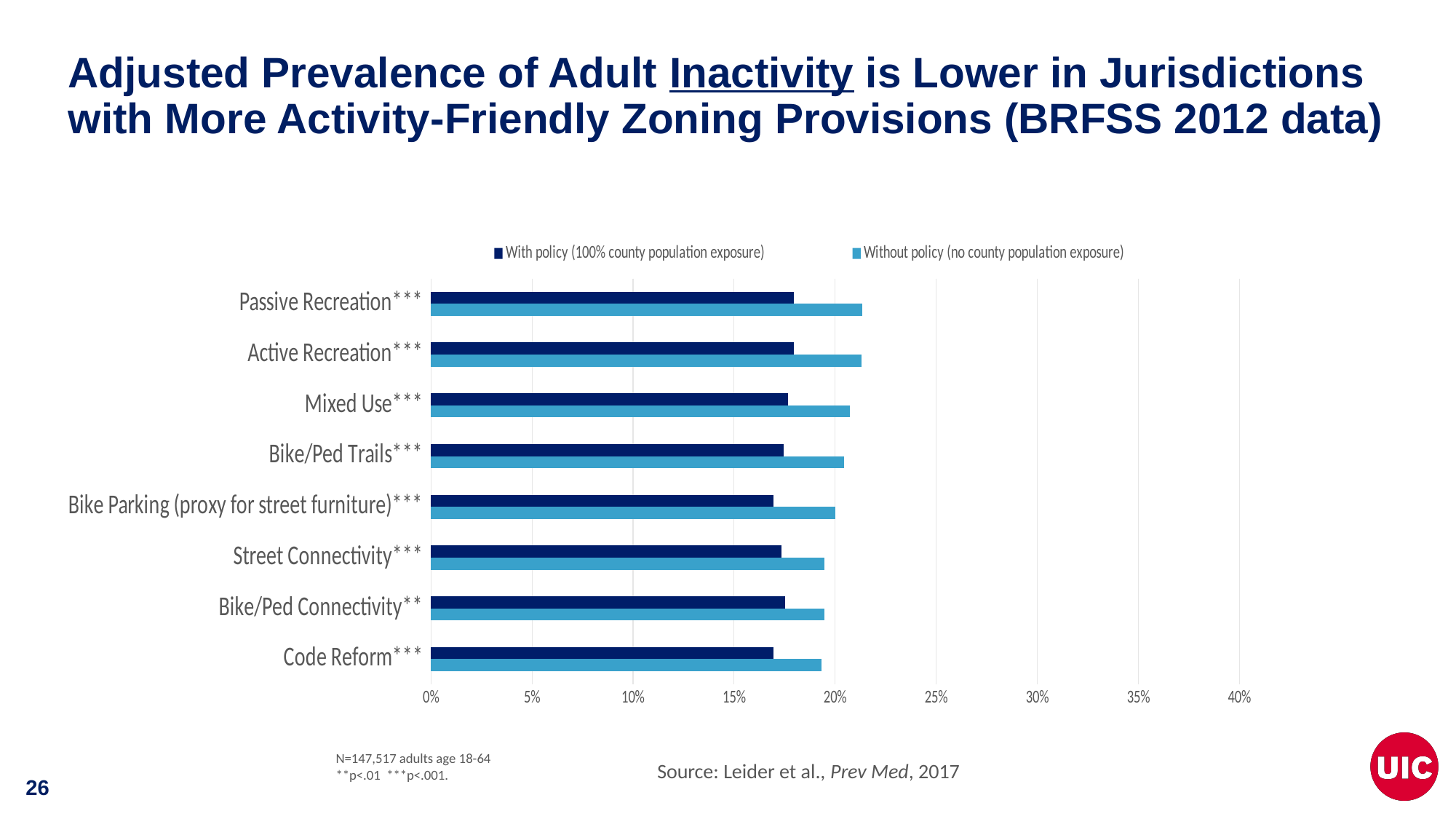
What are the two series named in the chart legend? With policy (100% county population exposure) and Without policy (no county population exposure) How many series does the chart legend list? 2 Which series is drawn in the darker navy colour? With policy (100% county population exposure) Is the 'With policy' value for Bike Parking (proxy for street furniture)*** greater or less than 20%? less For Code Reform***, which is larger: the 'With policy' value or the 'Without policy' value? Without policy How many zoning provision categories are plotted on the chart? 8 What kind of chart is shown on the slide? bar chart For Passive Recreation***, which is larger: the 'With policy' value or the 'Without policy' value? Without policy Is the 'With policy' value for Passive Recreation*** greater or less than 20%? less Is the 'Without policy' value for Passive Recreation*** greater or less than 20%? greater